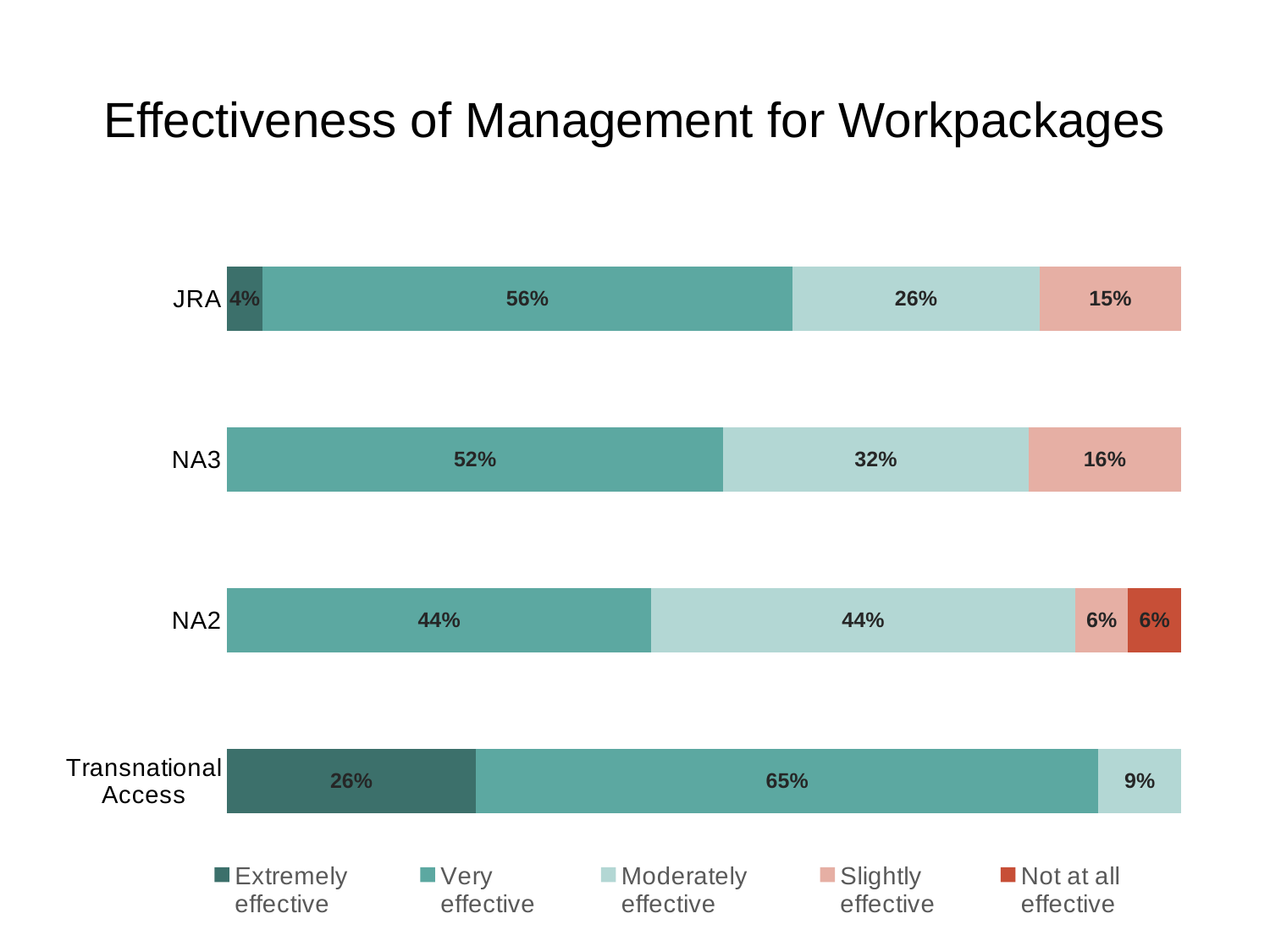
What is the difference between the 'Slightly effective' values for NA3 and JRA? 1% What is the 'Not at all effective' value for NA2? 6% What is the title of the chart? Effectiveness of Management for Workpackages What is the 'Extremely effective' value for Transnational Access? 26% What kind of chart is shown on the slide? Stacked bar chart How many workpackage categories are shown on the chart? 4 What percentage of respondents rated JRA management as 'Very effective'? 56% Which workpackage has the highest 'Very effective' percentage? Transnational Access What is the 'Moderately effective' value for NA3? 32% How many series does the legend list? 5 Which is larger: the 'Very effective' value for NA3 or for NA2? NA3 Which workpackage has the lowest 'Moderately effective' percentage? Transnational Access